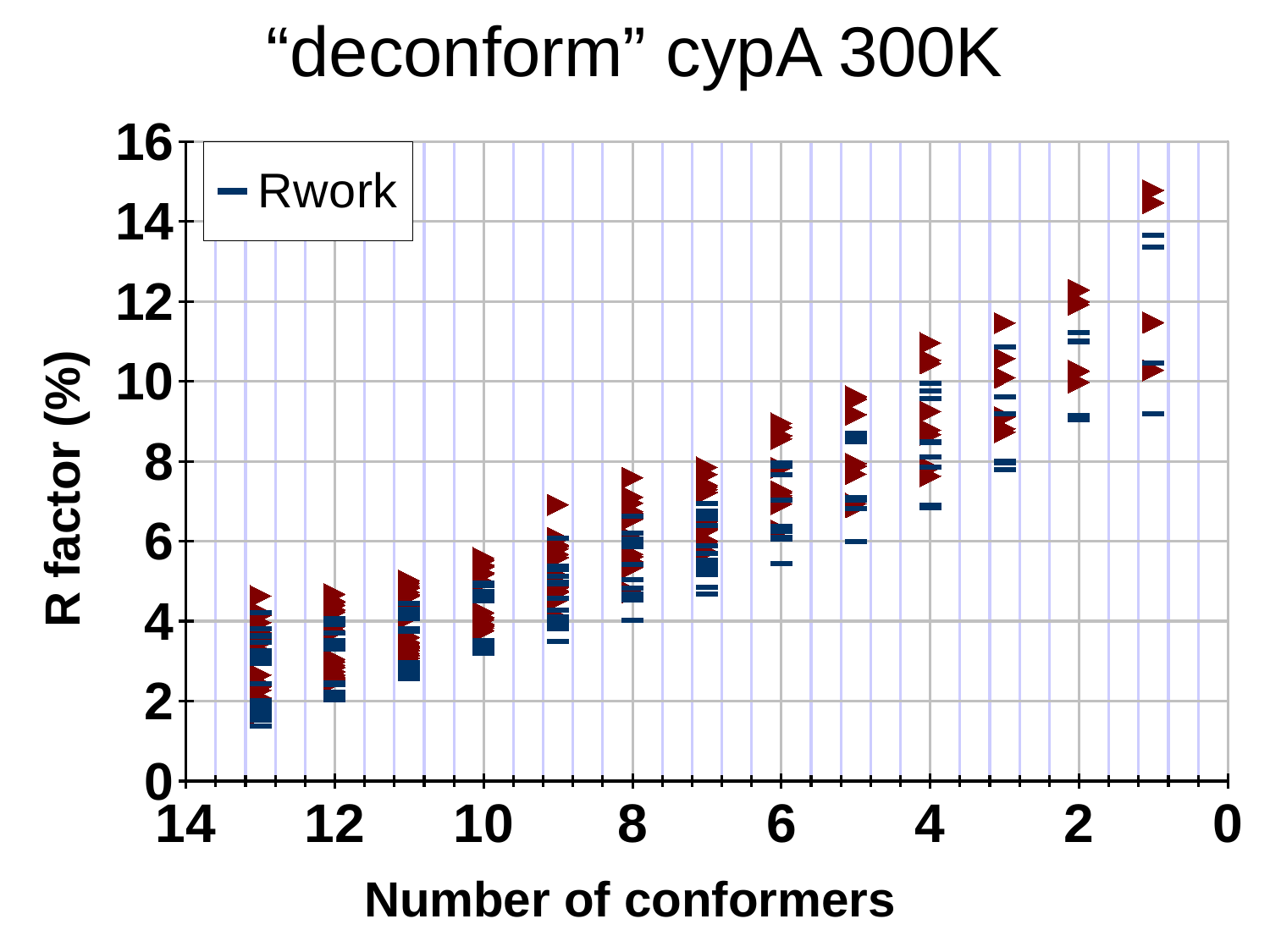
Is the lowest Rwork value at 4 conformers greater or less than 8? less How many series does the legend list? 1 What kind of chart is shown on the slide? scatter plot Which has higher red triangle values: 1 conformer or 13 conformers? 1 conformer Are all the R factor values at 13 conformers greater or less than 6? less Do the R factor values rise or fall as the number of conformers decreases from 13 to 1? rise How many distinct numbers of conformers have data points plotted? 13 What is the highest value shown on the y axis? 16 Is the highest red triangle value at 6 conformers greater or less than 8? greater What is the title of the chart? "deconform" cypA 300K What is the label of the y axis? R factor (%)